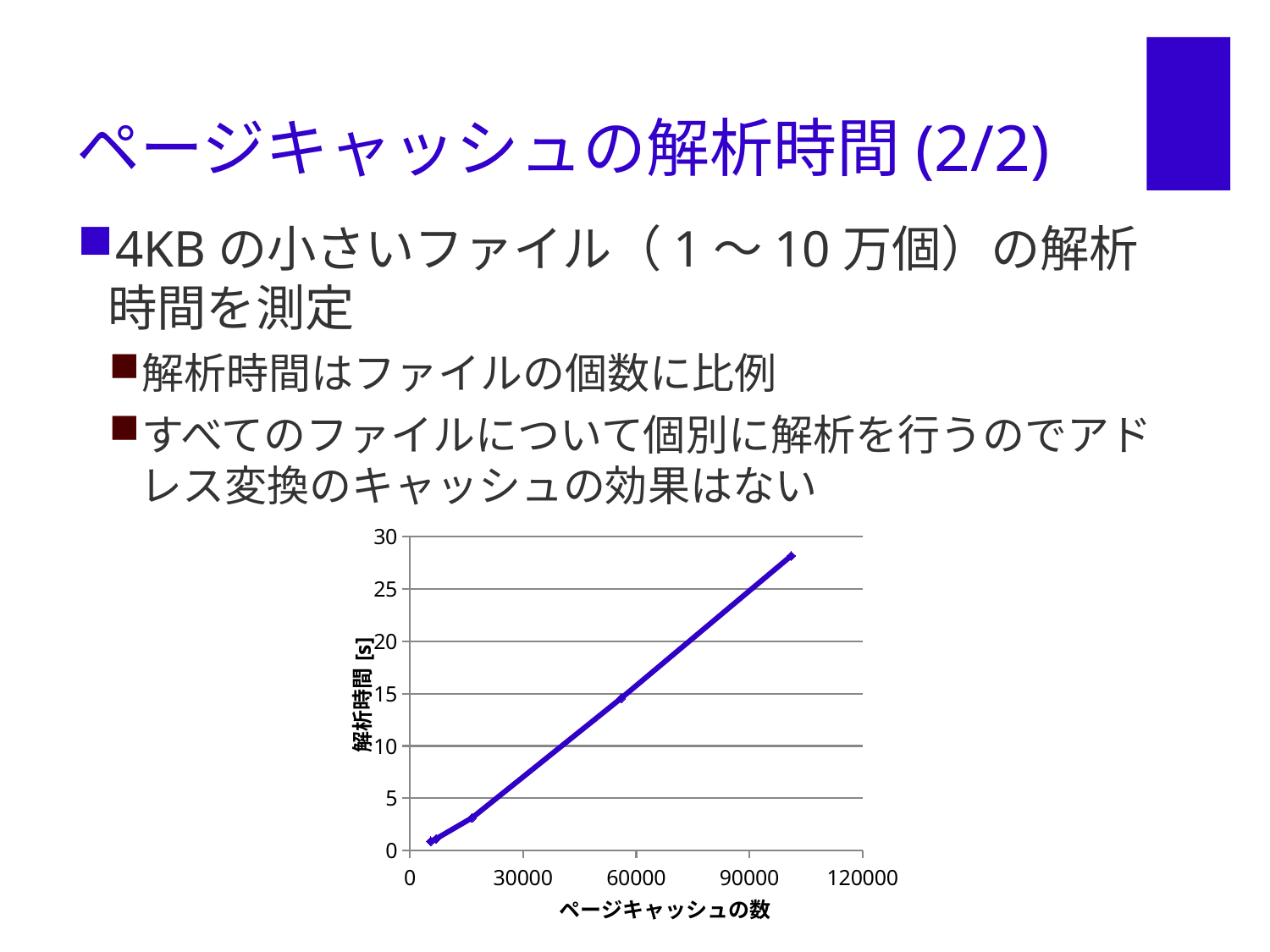
Is the analysis time at about 100000 page caches greater or less than 30 seconds? less What is the label of the x axis of the chart? ページキャッシュの数 Is the analysis time at about 16000 page caches greater or less than 5 seconds? less Which plotted point has the highest analysis time, the one at about 16000 page caches or the one at about 100000 page caches? the one at about 100000 page caches What is the highest tick value shown on the y axis? 30 Do the values rise or fall as the number of page caches increases along the x axis? rise Is the analysis time at about 56000 page caches greater or less than 10 seconds? greater What is the label of the y axis of the chart? 解析時間 [s] What kind of chart is shown on the slide? line chart How many data points are plotted on the line? 5